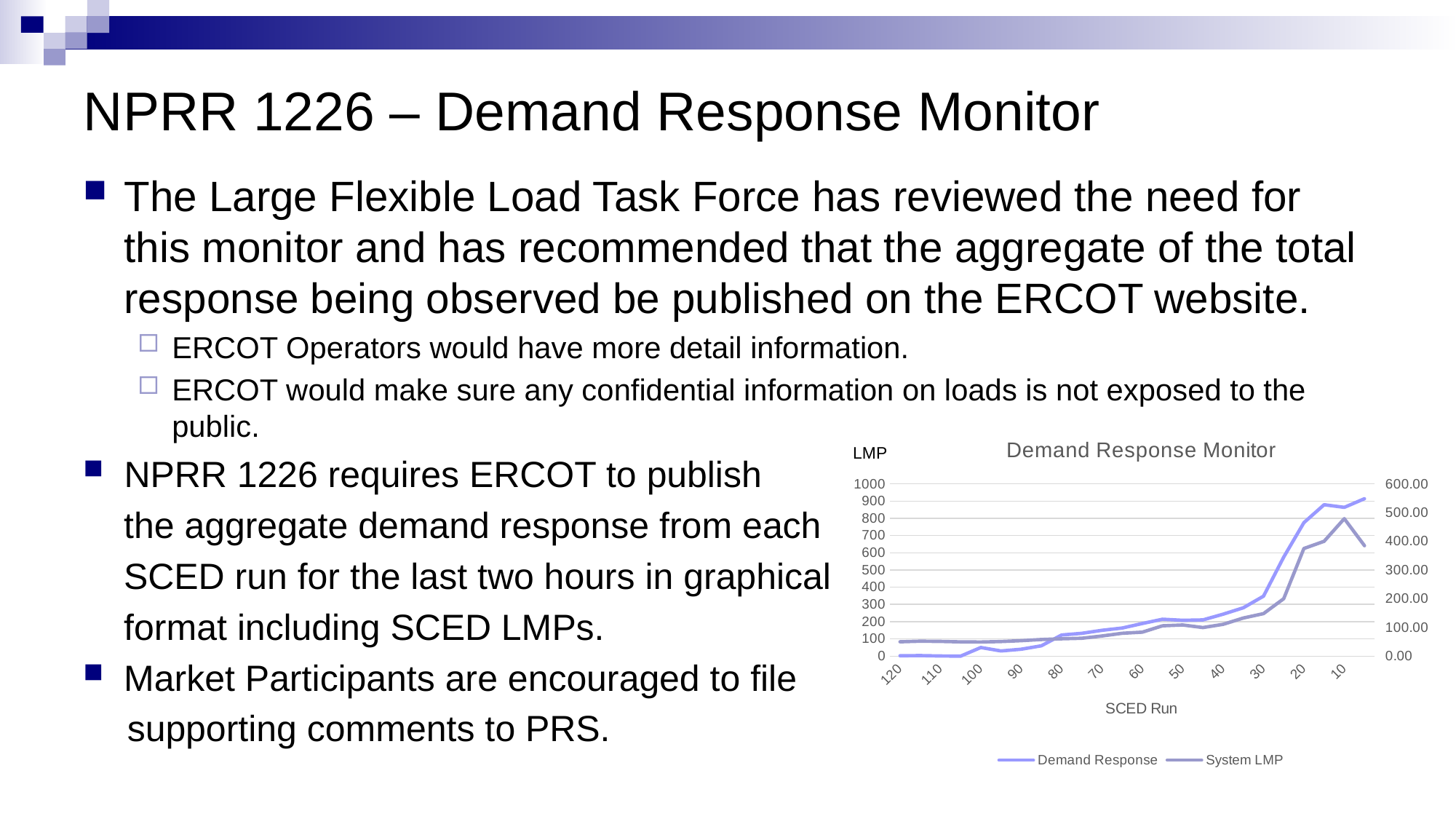
What is the highest value shown on the right vertical axis of the Demand Response Monitor chart? 600.00 Does the Demand Response line generally rise or fall moving from SCED Run 120 to SCED Run 10? rise Between SCED Run 20 and SCED Run 10, does the System LMP line rise or fall? rise How many series does the legend of the Demand Response Monitor chart list? 2 What is the title of the chart on the slide? Demand Response Monitor What are the two series named in the legend of the Demand Response Monitor chart? Demand Response and System LMP How many SCED Run tick labels are shown along the x axis of the Demand Response Monitor chart? 12 What is the highest value shown on the left vertical axis of the Demand Response Monitor chart? 1000 What kind of chart is the Demand Response Monitor chart? line chart What is the first SCED Run label on the left of the x axis of the Demand Response Monitor chart? 120 What is the x-axis title of the Demand Response Monitor chart? SCED Run